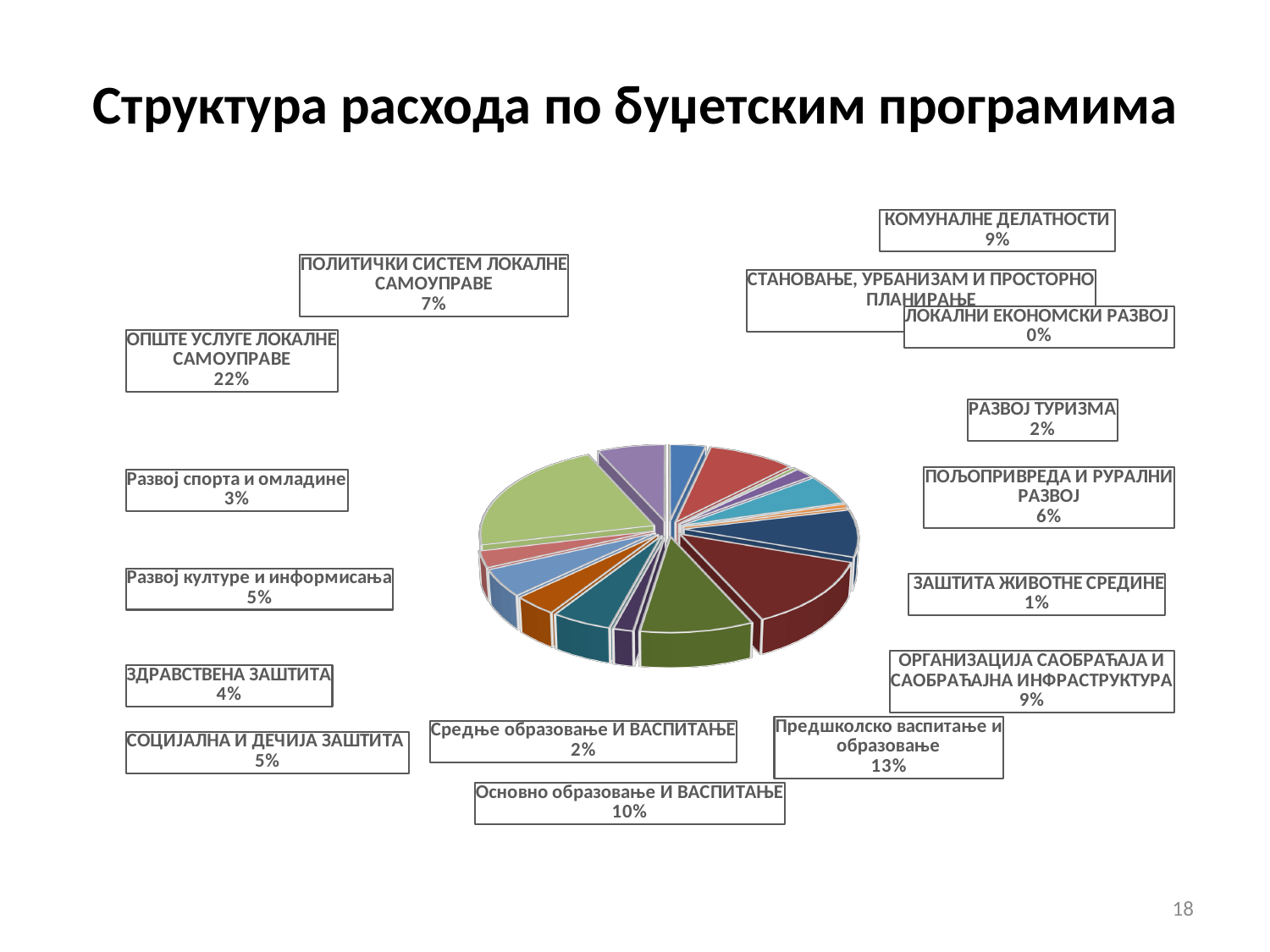
What kind of chart is shown on the slide? pie chart What share of expenditure goes to ОПШТЕ УСЛУГЕ ЛОКАЛНЕ САМОУПРАВЕ? 22% Which has a larger share: ЗДРАВСТВЕНА ЗАШТИТА or ПОЛИТИЧКИ СИСТЕМ ЛОКАЛНЕ САМОУПРАВЕ? ПОЛИТИЧКИ СИСТЕМ ЛОКАЛНЕ САМОУПРАВЕ What percentage is shown for Основно образовање И ВАСПИТАЊЕ? 10% What is the title of the chart on the slide? Структура расхода по буџетским програмима How many percentage points larger is the share for ОПШТЕ УСЛУГЕ ЛОКАЛНЕ САМОУПРАВЕ than for Предшколско васпитање и образовање? 9 percentage points What percentage is shown for ПОЉОПРИВРЕДА И РУРАЛНИ РАЗВОЈ? 6% What percentage is shown for Предшколско васпитање и образовање? 13% Which budget programme has the largest share of expenditure? ОПШТЕ УСЛУГЕ ЛОКАЛНЕ САМОУПРАВЕ Which budget programme has the smallest share of expenditure? ЛОКАЛНИ ЕКОНОМСКИ РАЗВОЈ What percentage is shown for ЗАШТИТА ЖИВОТНЕ СРЕДИНЕ? 1% Which has a larger share: Развој спорта и омладине or Развој културе и информисања? Развој културе и информисања